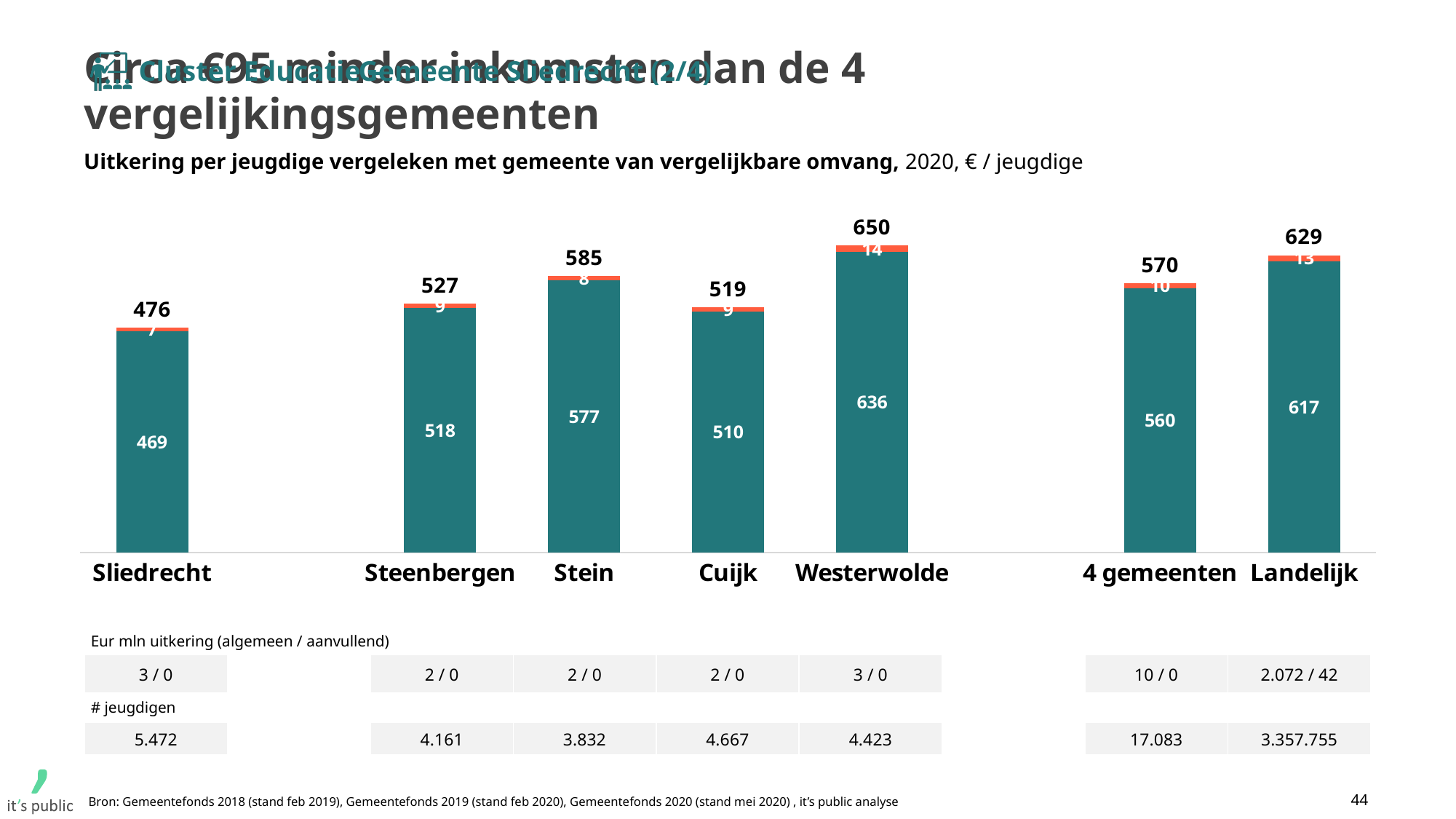
What is the value of the large teal segment of the 4 gemeenten bar? 560 Which category has the lowest total value? Sliedrecht Which category has the highest total value? Westerwolde What is the difference between the total for Westerwolde and the total for Sliedrecht? 174 What is the difference between the total for Landelijk and the total for 4 gemeenten? 59 What kind of chart is shown on the slide? Stacked bar chart What is the total value shown above the bar for Sliedrecht? 476 Which has a larger total, Stein or Cuijk? Stein What is the value of the large teal segment of the Stein bar? 577 How many categories (bars) are shown in the chart? 7 What is the total value shown above the bar for Landelijk? 629 According to the chart subtitle, in what unit are the values expressed? € / jeugdige